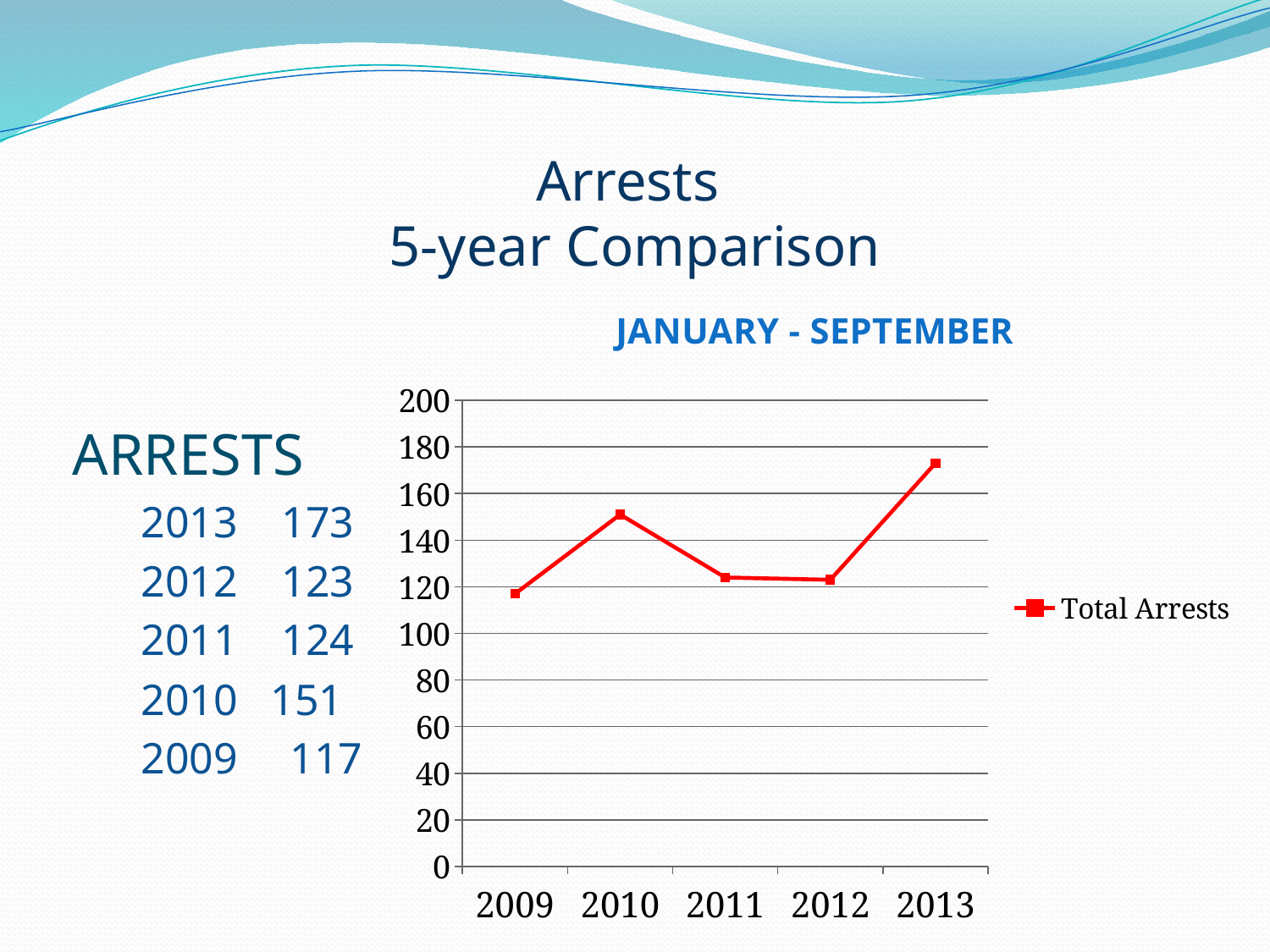
Which year has the highest number of Total Arrests? 2013 What is the value of Total Arrests for 2010? 151 What is the value of Total Arrests for 2009? 117 What is the difference in Total Arrests between 2013 and 2012? 50 Which year has the lowest number of Total Arrests? 2009 What is the name of the series shown in the chart legend? Total Arrests What is the value of Total Arrests for 2013? 173 Which year has more Total Arrests, 2010 or 2012? 2010 What kind of chart is shown on the slide? line chart How many series does the chart legend list? 1 How many years are plotted on the x axis of the chart? 5 Is the value for Total Arrests in 2013 greater or less than 160? greater